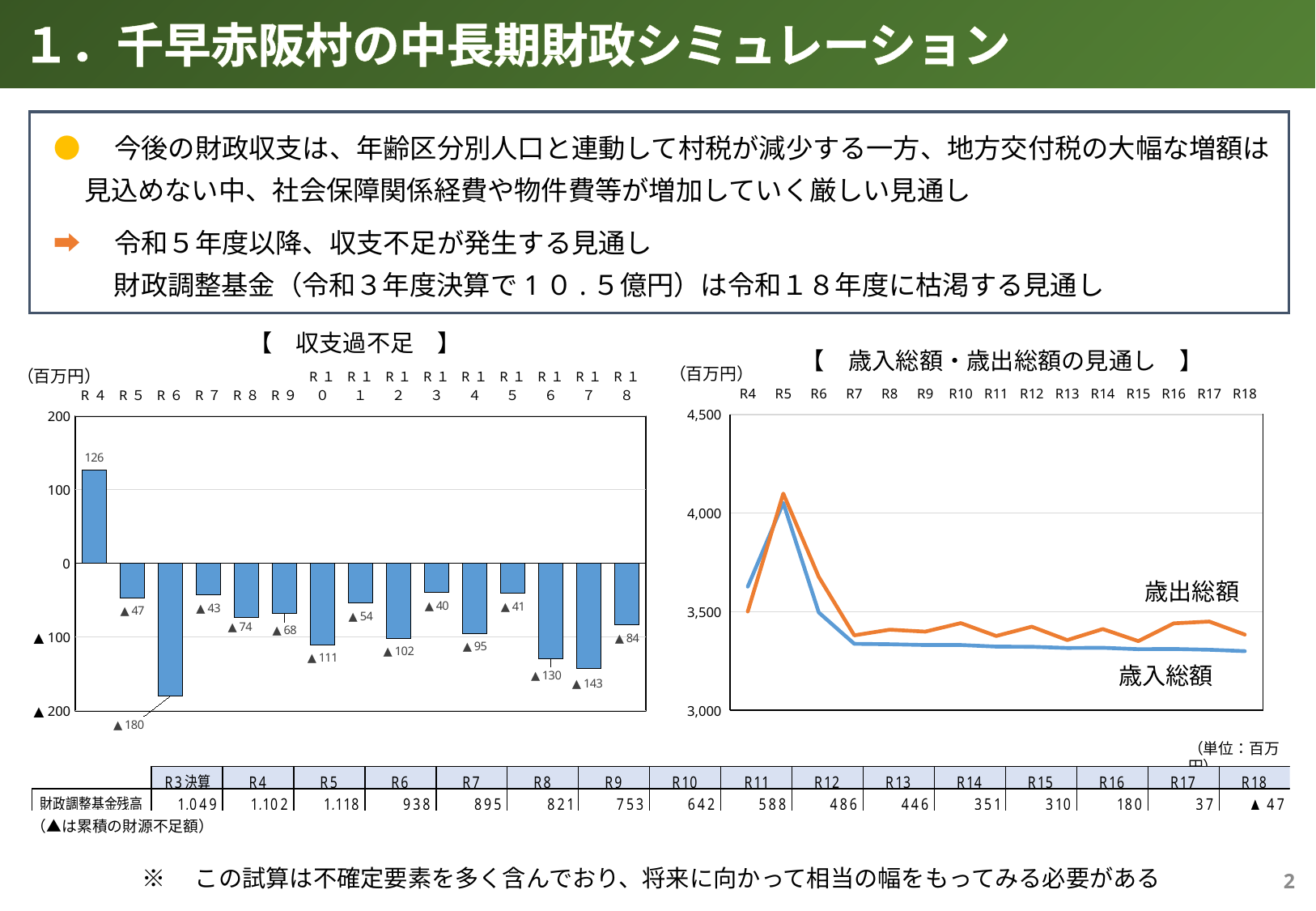
In the 収支過不足 chart, which year has the highest value? R4 How many years are plotted in the 収支過不足 chart? 15 In the 歳入総額・歳出総額の見通し chart, is the value of 歳出総額 at R5 greater or less than 4,000? greater In the 歳入総額・歳出総額の見通し chart, is the value of 歳入総額 at R18 greater or less than 3,500? less In the 収支過不足 chart, which year has the lowest value? R6 In the 収支過不足 chart, what is the value for R17? ▲143 In the 収支過不足 chart, what is the value for R4? 126 In the 収支過不足 chart, what is the difference between the values for R16 and R17? 13 What kind of chart is the 収支過不足 chart? Bar chart How many series are shown in the 歳入総額・歳出総額の見通し chart? 2 In the 収支過不足 chart, which is larger, the value for R10 or the value for R12? R12 In the 収支過不足 chart, what is the value for R6? ▲180